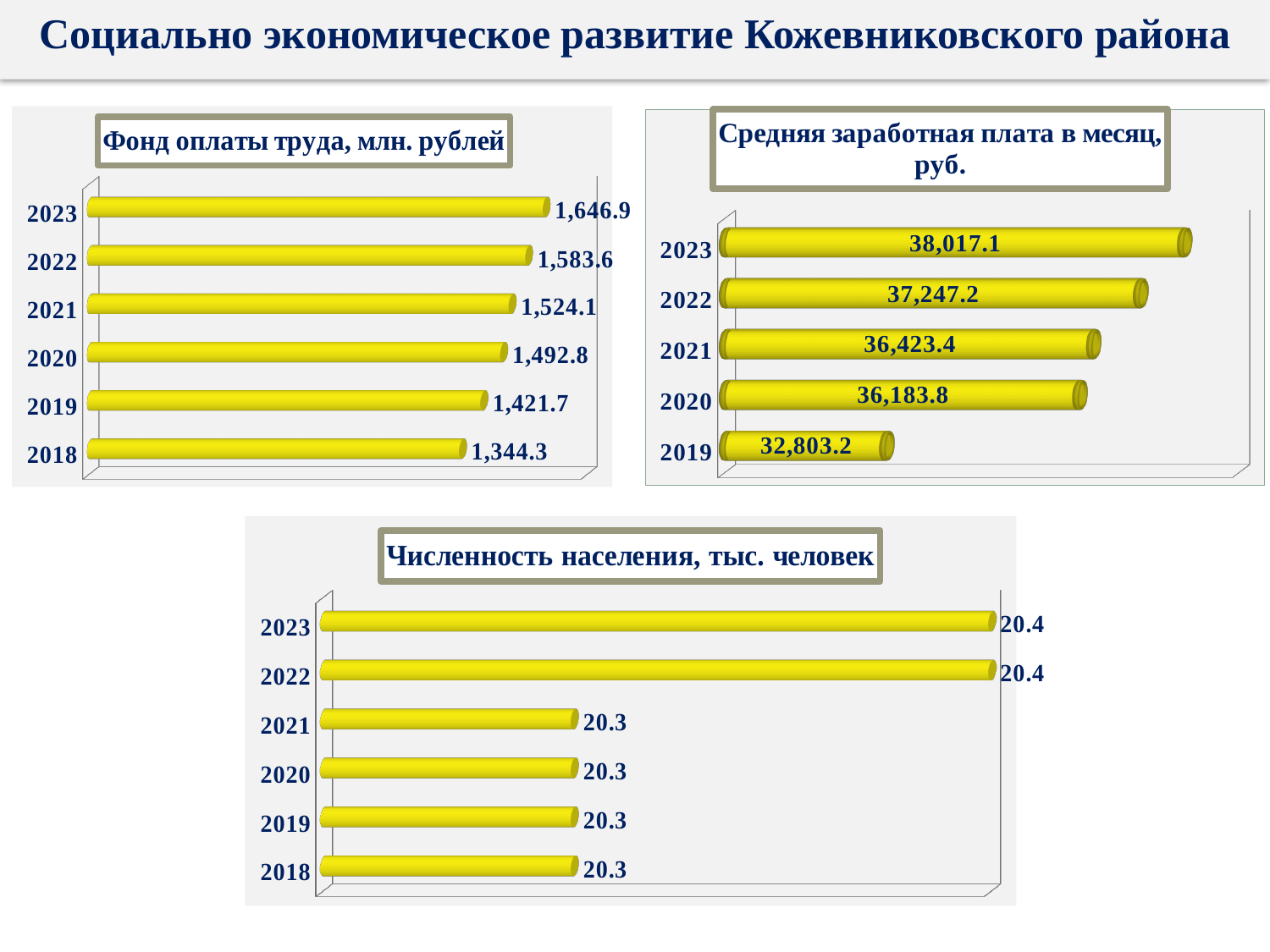
In the chart 'Средняя заработная плата в месяц, руб.', what is the value for 2020? 36,183.8 In the chart 'Средняя заработная плата в месяц, руб.', what is the difference between the 2023 and 2019 values? 5,213.9 In the chart 'Средняя заработная плата в месяц, руб.', which year has the highest value? 2023 In the chart 'Численность населения, тыс. человек', is the value for 2022 larger or smaller than the value for 2019? larger In the chart 'Численность населения, тыс. человек', what is the value for 2021? 20.3 In the chart 'Фонд оплаты труда, млн. рублей', which year has the lowest value? 2018 In the chart 'Фонд оплаты труда, млн. рублей', do the values rise or fall from 2018 to 2023? rise What type of chart is 'Численность населения, тыс. человек'? bar chart In the chart 'Средняя заработная плата в месяц, руб.', how many years are shown? 5 In the chart 'Фонд оплаты труда, млн. рублей', what is the value for 2023? 1,646.9 In the chart 'Фонд оплаты труда, млн. рублей', how many years are shown? 6 In the chart 'Фонд оплаты труда, млн. рублей', what is the difference between the 2023 and 2018 values? 302.6